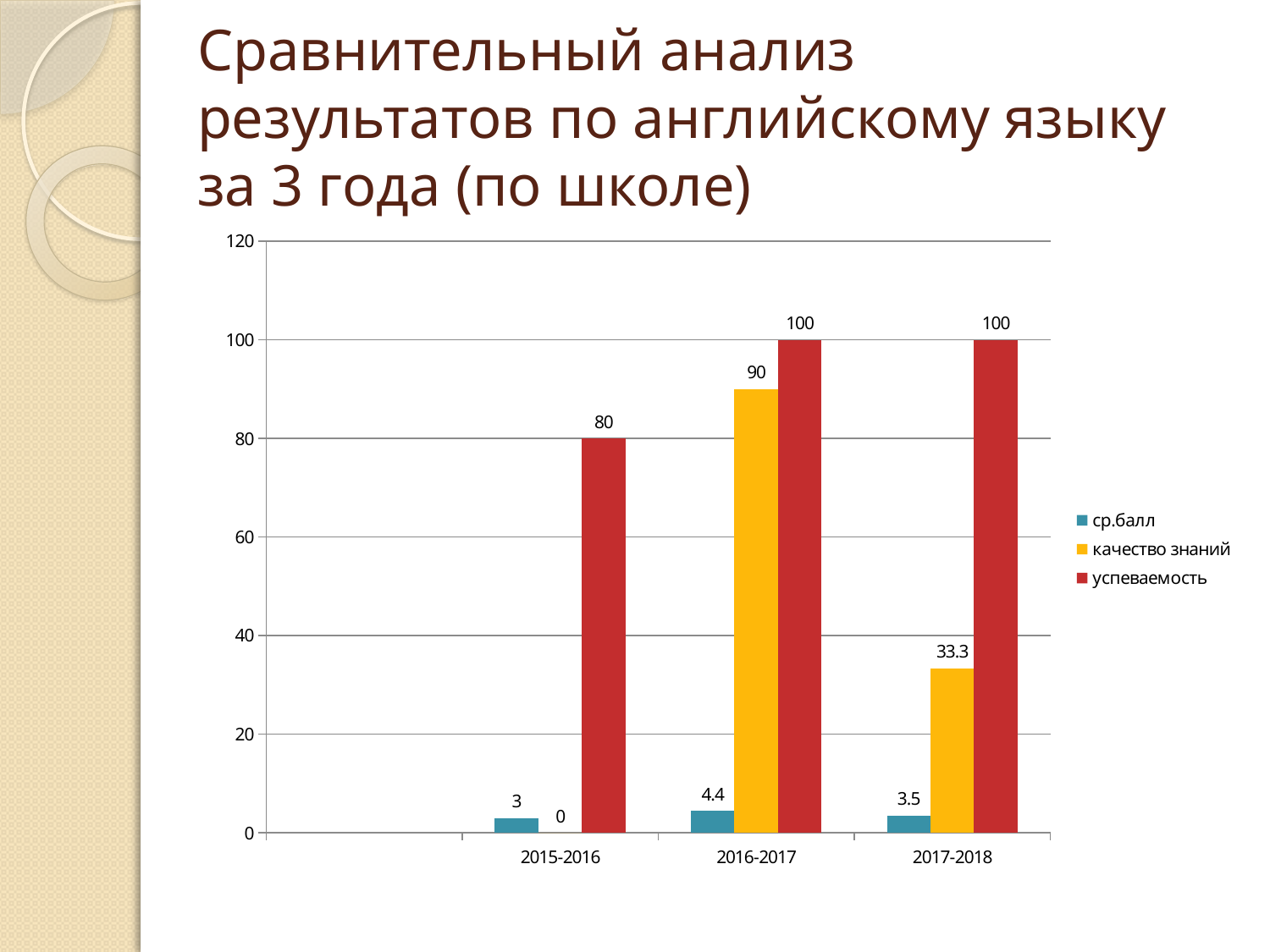
What is the value of успеваемость for 2015-2016? 80 Which colour represents успеваемость in the legend? red How many series does the legend list? 3 What is the difference between качество знаний in 2016-2017 and in 2017-2018? 56.7 What is the value of качество знаний for 2015-2016? 0 In which year is ср.балл highest? 2016-2017 Which is larger: успеваемость in 2015-2016 or in 2016-2017? 2016-2017 What is the value of качество знаний for 2016-2017? 90 How many year categories are shown on the x axis? 3 What kind of chart is shown on the slide? bar chart In which year is качество знаний lowest? 2015-2016 What is the value of ср.балл for 2017-2018? 3.5